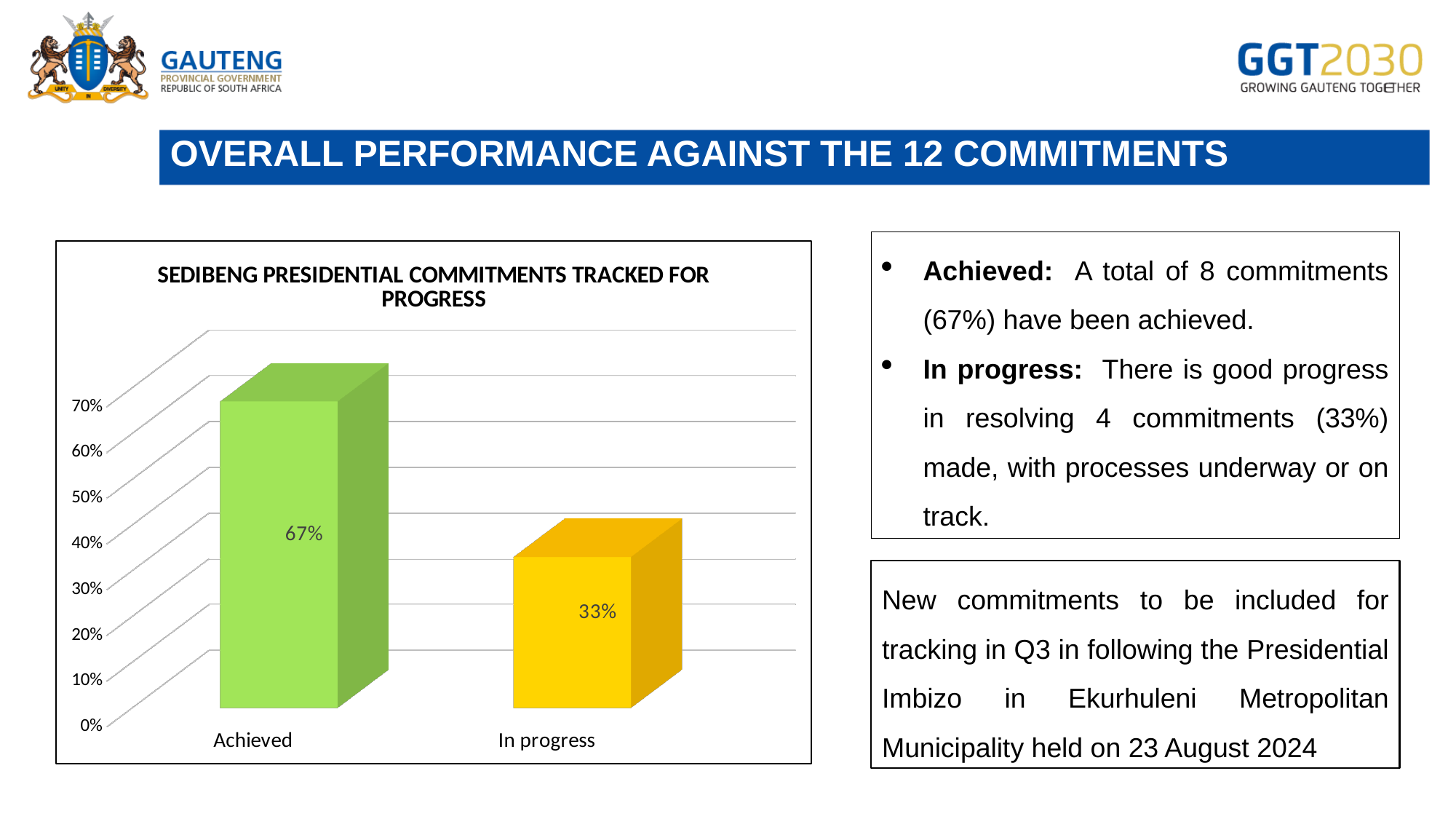
What is the difference between the Achieved and In progress values? 34% What is the value for In progress? 33% What is the title of the chart? SEDIBENG PRESIDENTIAL COMMITMENTS TRACKED FOR PROGRESS Which category has the lowest value? In progress What colour is the bar for In progress? Yellow Which category has the highest value? Achieved Is the value for In progress greater or less than 40%? less What is the value for Achieved? 67% What kind of chart is shown on the slide? Bar chart Which is larger, the value for Achieved or the value for In progress? Achieved How many categories are shown on the chart? 2 Is the value for Achieved greater or less than 60%? greater